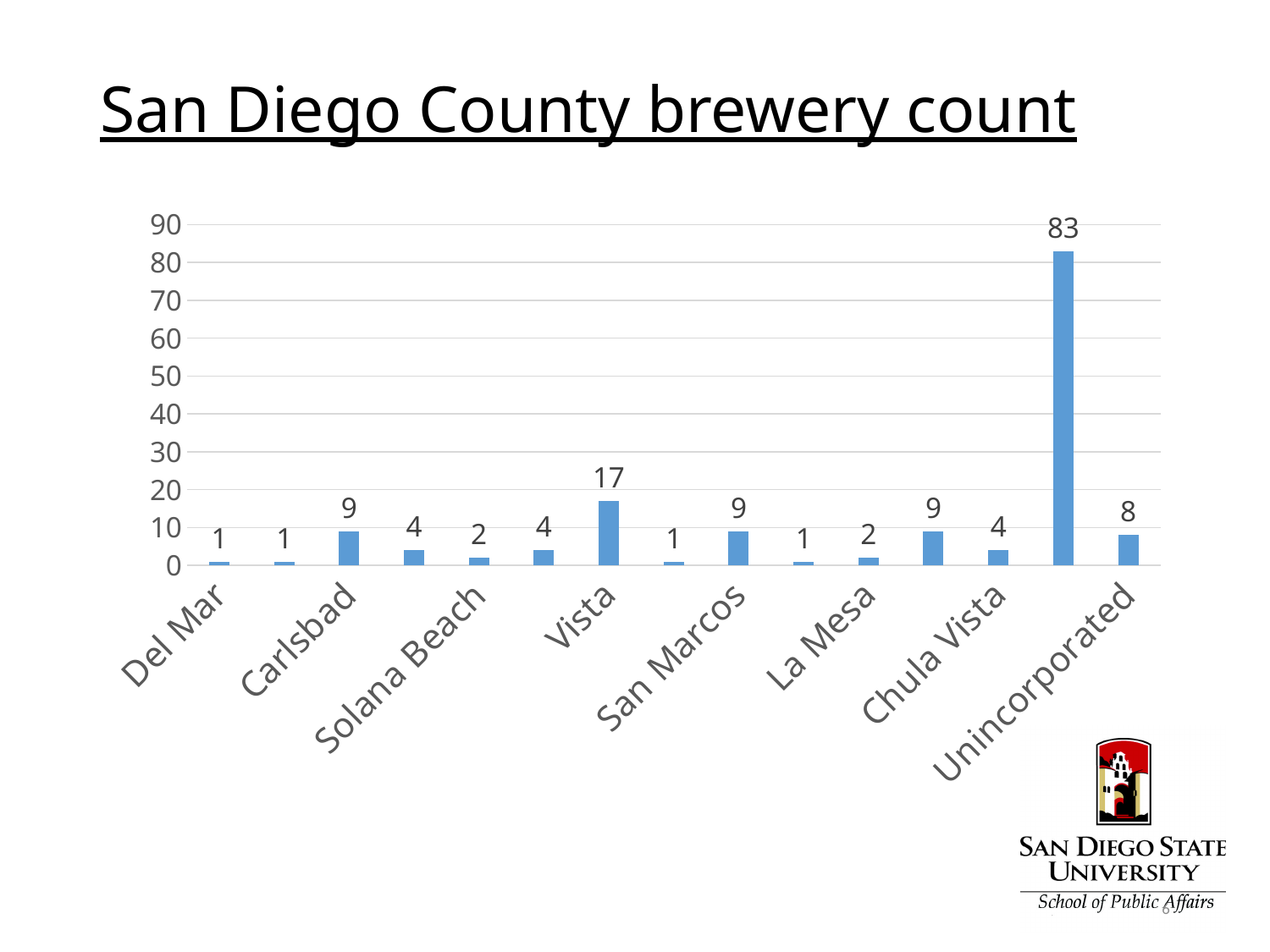
What is the brewery count for Carlsbad? 9 What is the brewery count for Vista? 17 Which has more breweries, Carlsbad or Solana Beach? Carlsbad What is the brewery count for La Mesa? 2 What is the brewery count for Del Mar? 1 What is the title of the slide? San Diego County brewery count What is the difference between the brewery counts for Vista and San Marcos? 8 What is the brewery count for Unincorporated? 8 What is the brewery count for Chula Vista? 4 What kind of chart is shown on the slide? Bar chart Is the value for Vista greater or less than 10? greater How many bars are plotted in the chart? 15